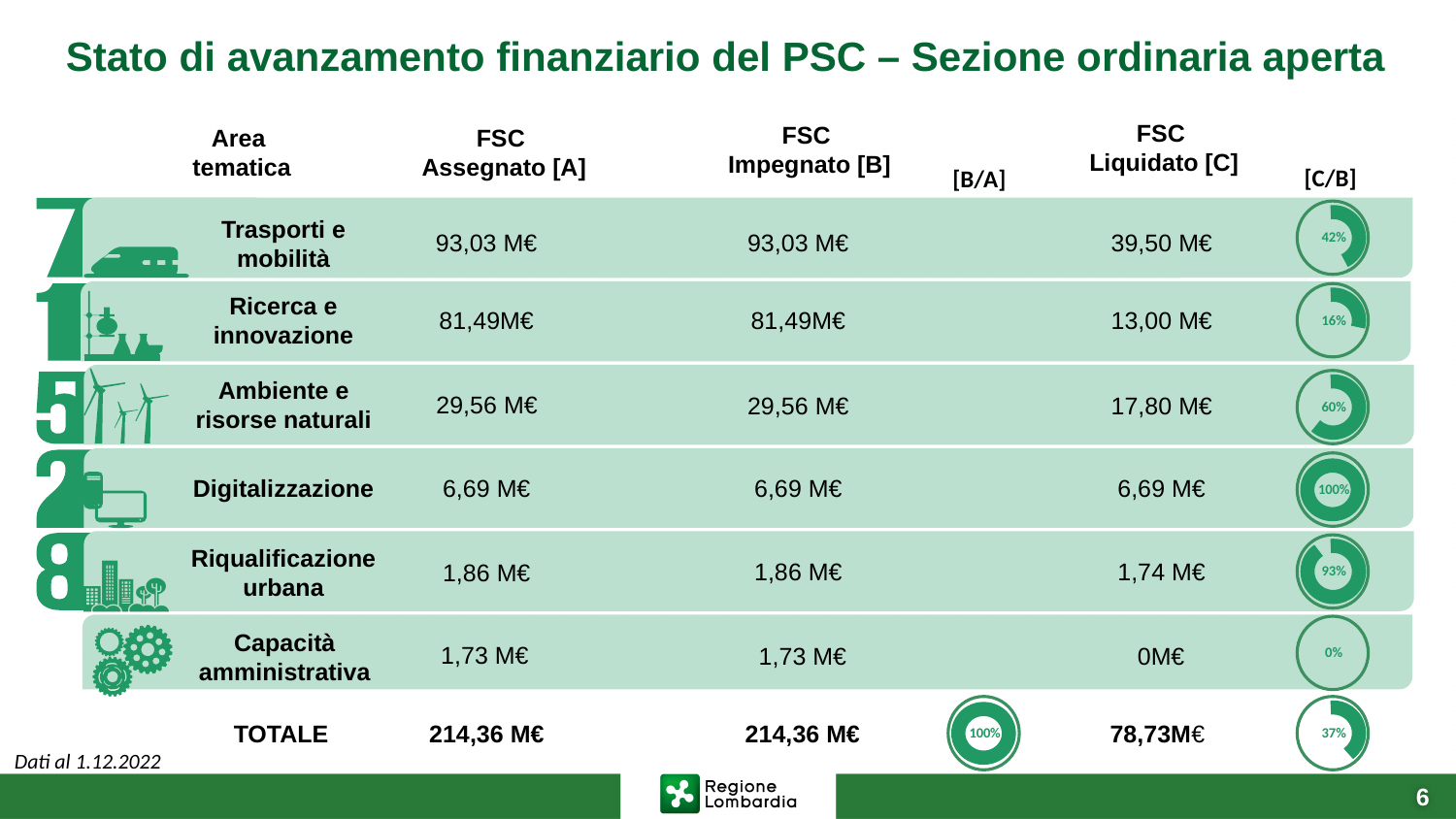
What percentage does the [B/A] doughnut chart show for the TOTALE row? 100% What percentage does the [C/B] doughnut chart show for Riqualificazione urbana? 93% How many doughnut charts are shown in the [C/B] column, including the TOTALE row? 7 Which area tematica has the lowest [C/B] percentage in its doughnut chart? Capacità amministrativa Which area tematica has the highest [C/B] percentage in its doughnut chart? Digitalizzazione What percentage does the [C/B] doughnut chart show for Ricerca e innovazione? 16% What is the difference between the [C/B] percentages for Ambiente e risorse naturali and Trasporti e mobilità? 18% What percentage does the [C/B] doughnut chart show for the TOTALE row? 37% What percentage does the [C/B] doughnut chart show for Trasporti e mobilità? 42% Which is larger, the [C/B] percentage for Riqualificazione urbana or for Ricerca e innovazione? Riqualificazione urbana What percentage does the [C/B] doughnut chart show for Ambiente e risorse naturali? 60% What kind of chart is used to show the [C/B] percentages? Doughnut chart